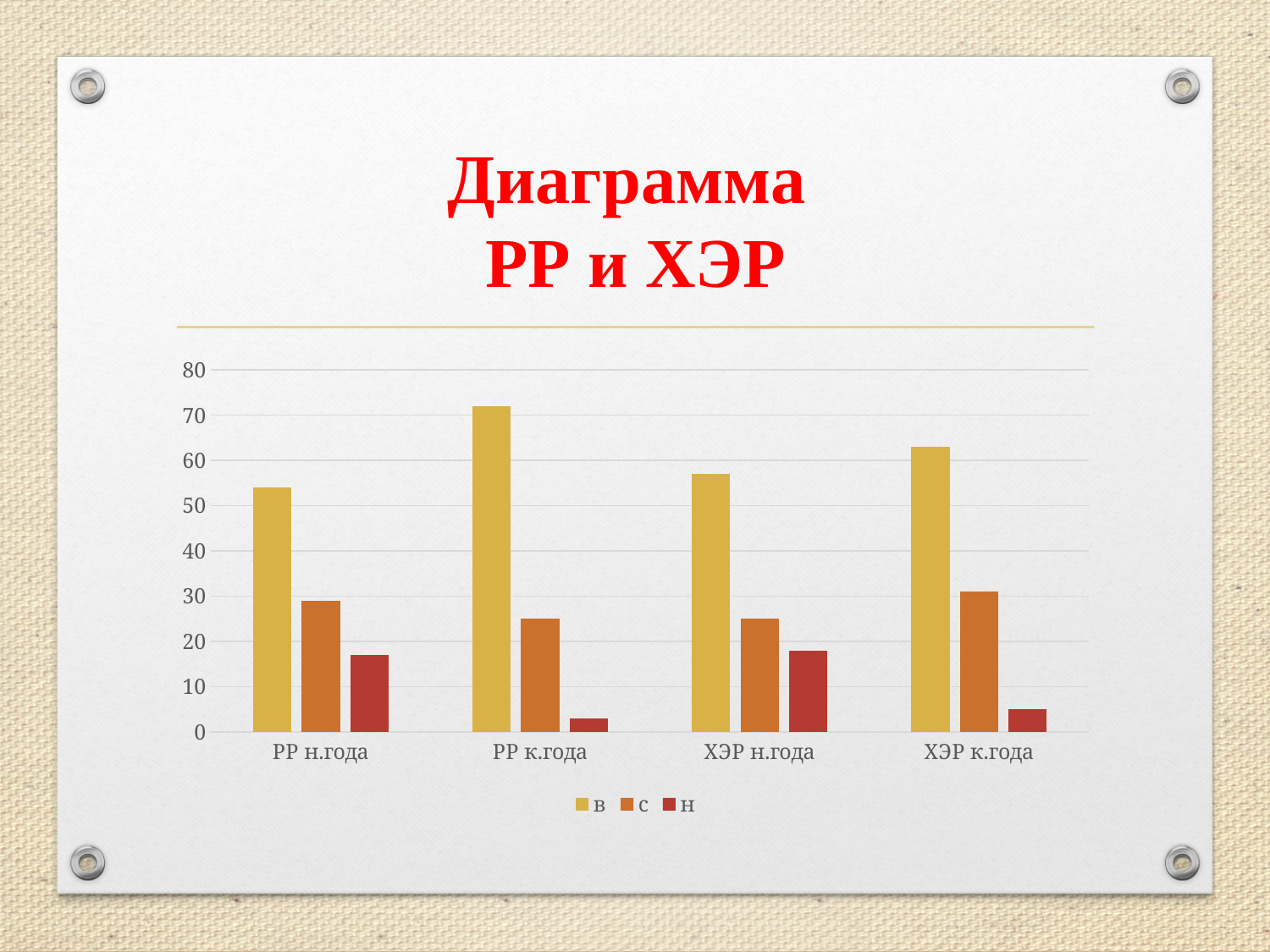
Which category has the lowest value for series "в"? РР н.года Is the value for series "в" at РР к.года greater or less than 70? greater Which category has the lowest value for series "н"? РР к.года Which category has the highest value for series "в"? РР к.года What is the title of the slide containing the chart? Диаграмма РР и ХЭР Is the value for series "в" at ХЭР к.года greater or less than 60? greater What kind of chart is shown on the slide? bar chart Which is larger: the value for series "в" at ХЭР н.года or at ХЭР к.года? ХЭР к.года How many categories are shown on the x axis of the chart? 4 Which is larger: the value for series "н" at РР н.года or at РР к.года? РР н.года How many series does the legend list? 3 Is the value for series "н" at ХЭР к.года greater or less than 10? less